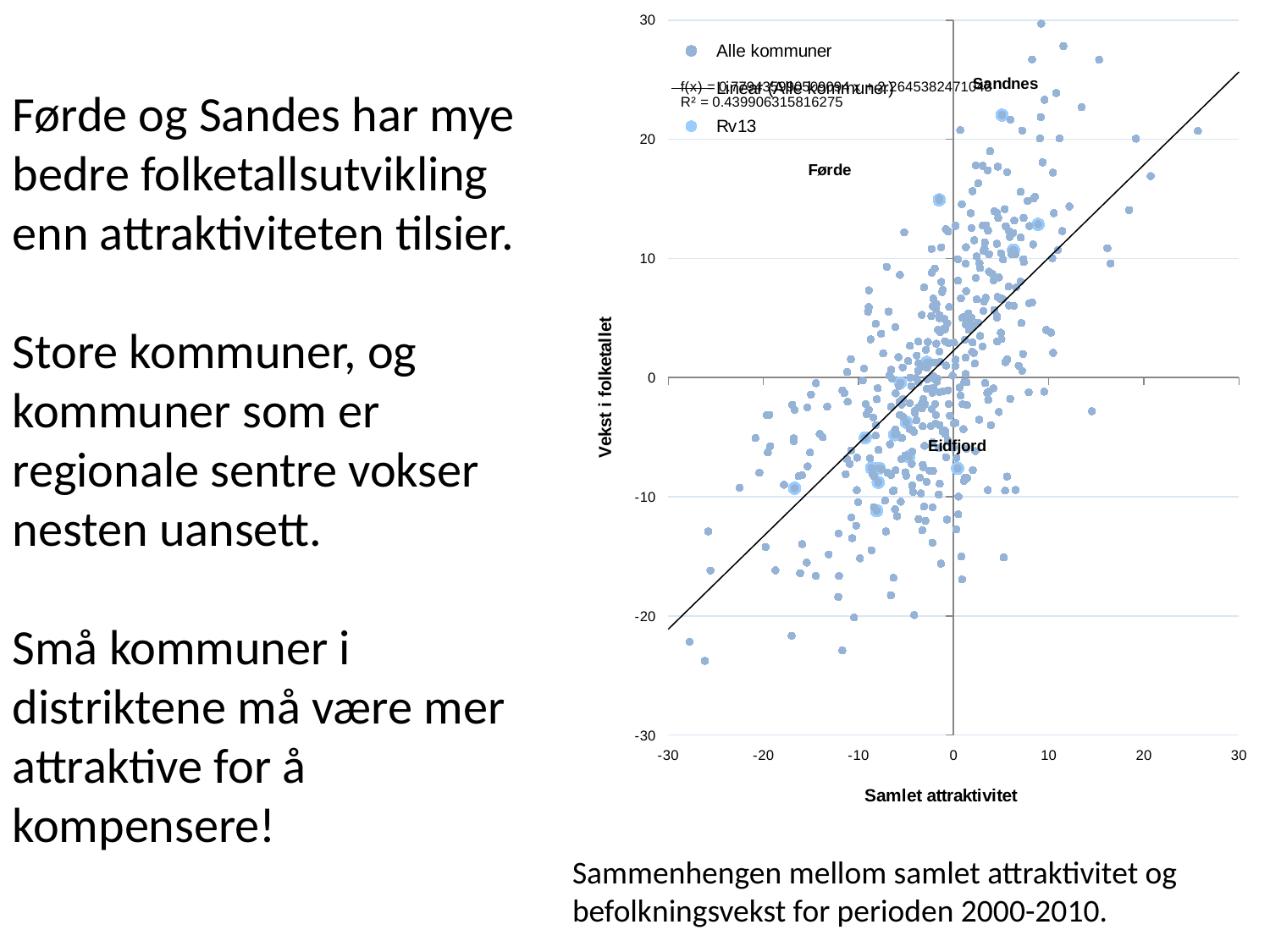
Is the Vekst i folketallet value for Sandnes greater or less than 10? greater Is the Vekst i folketallet value for Førde greater or less than 10? greater What kind of chart is shown on the slide? Scatter chart Is the Vekst i folketallet value for Eidfjord greater or less than 0? less What is the R² value printed on the chart? 0.439906315816275 Does the linear trendline rise or fall as Samlet attraktivitet increases? Rise What is the minimum value shown on the y axis of the chart? -30 What is the title of the y axis of the chart? Vekst i folketallet What is the title of the x axis of the chart? Samlet attraktivitet Which has the higher Vekst i folketallet, Sandnes or Eidfjord? Sandnes How many entries does the chart's legend list? 3 What is the maximum value shown on the x axis of the chart? 30